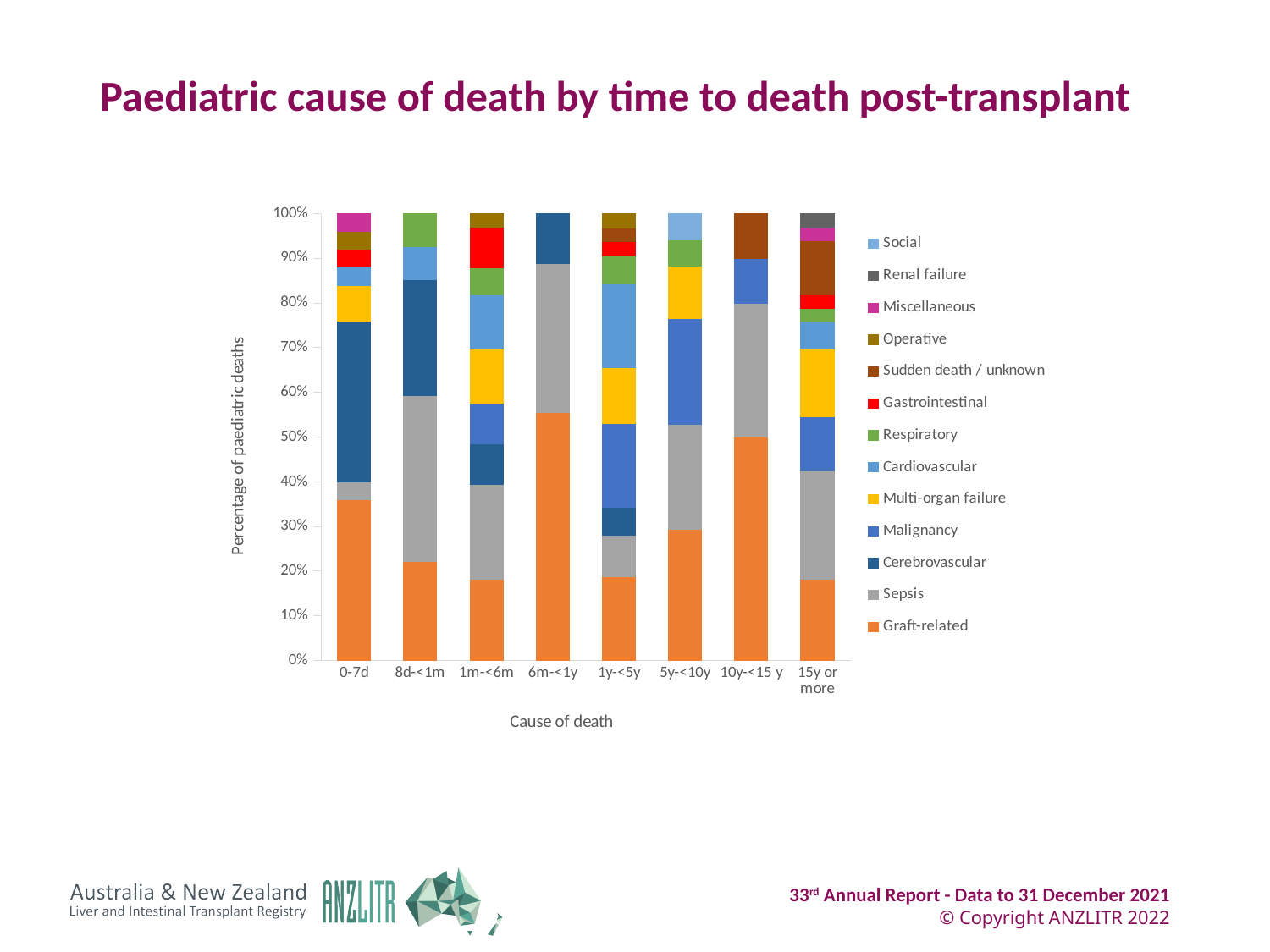
Is the Graft-related share for 6m-<1y greater or less than 50%? greater Which has the larger Cerebrovascular share, 0-7d or 8d-<1m? 0-7d Which time-to-death category has the largest Graft-related share? 6m-<1y Which has the larger Sepsis share, 0-7d or 8d-<1m? 8d-<1m What kind of chart is shown on the slide? Stacked bar chart Is the Graft-related share for 8d-<1m greater or less than 30%? less What is the label on the y axis? Percentage of paediatric deaths Is the Graft-related share for 0-7d greater or less than 40%? less How many time-to-death categories are shown on the x axis? 8 What is the title of the chart? Paediatric cause of death by time to death post-transplant How many causes of death does the legend list? 13 What does each stacked bar total? 100%